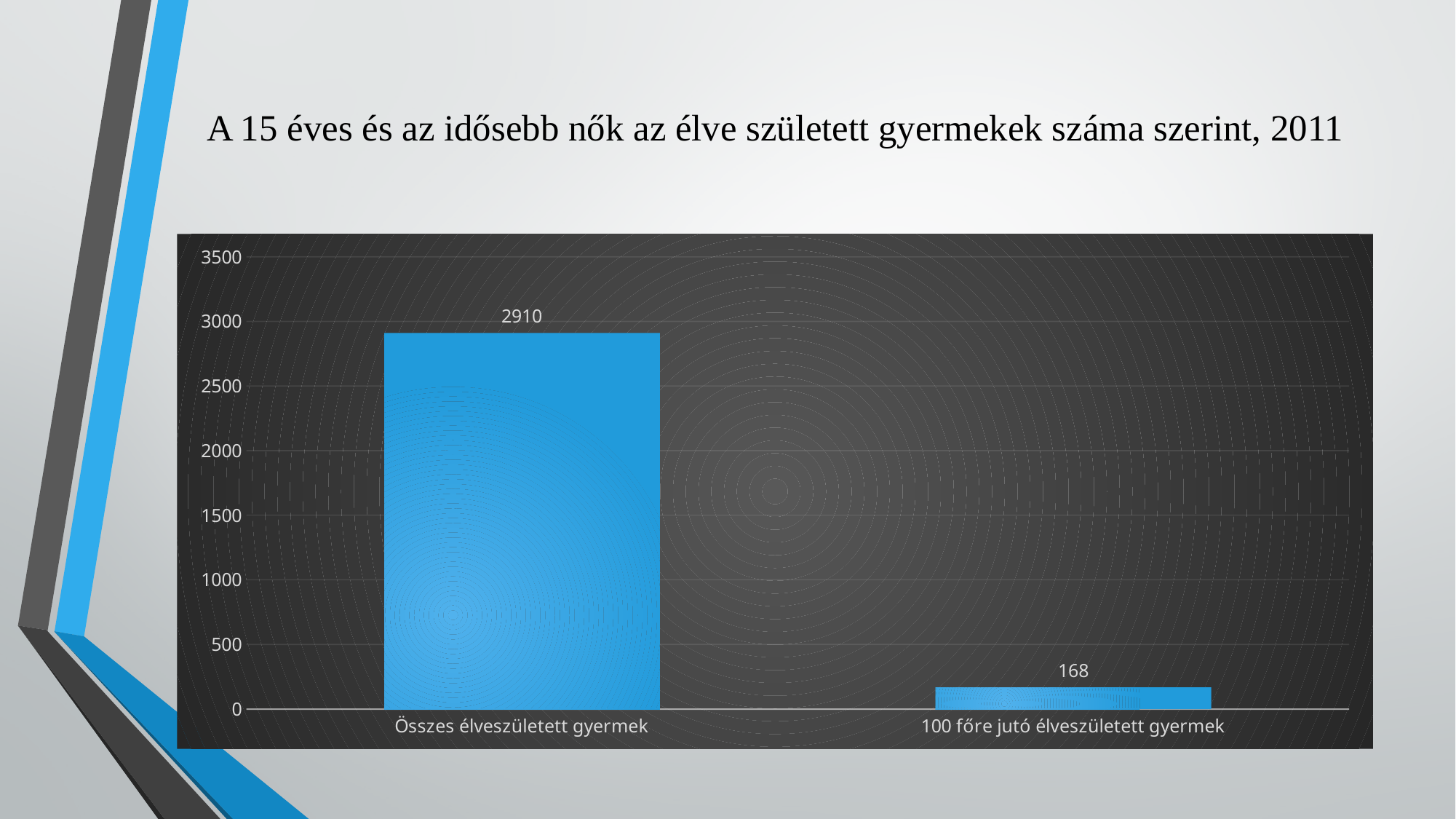
What is the difference between the values for "Összes élveszületett gyermek" and "100 főre jutó élveszületett gyermek"? 2742 What is the highest value shown on the vertical axis? 3500 Is the value for "Összes élveszületett gyermek" greater or less than 2500? greater Which category has the lowest value? 100 főre jutó élveszületett gyermek How many categories are shown in the chart? 2 What is the value for "100 főre jutó élveszületett gyermek"? 168 What is the title of the slide? A 15 éves és az idősebb nők az élve született gyermekek száma szerint, 2011 Which category has the highest value? Összes élveszületett gyermek What is the value for "Összes élveszületett gyermek"? 2910 What kind of chart is shown on the slide? bar chart Which is larger: the value for "Összes élveszületett gyermek" or for "100 főre jutó élveszületett gyermek"? Összes élveszületett gyermek Is the value for "100 főre jutó élveszületett gyermek" greater or less than 500? less